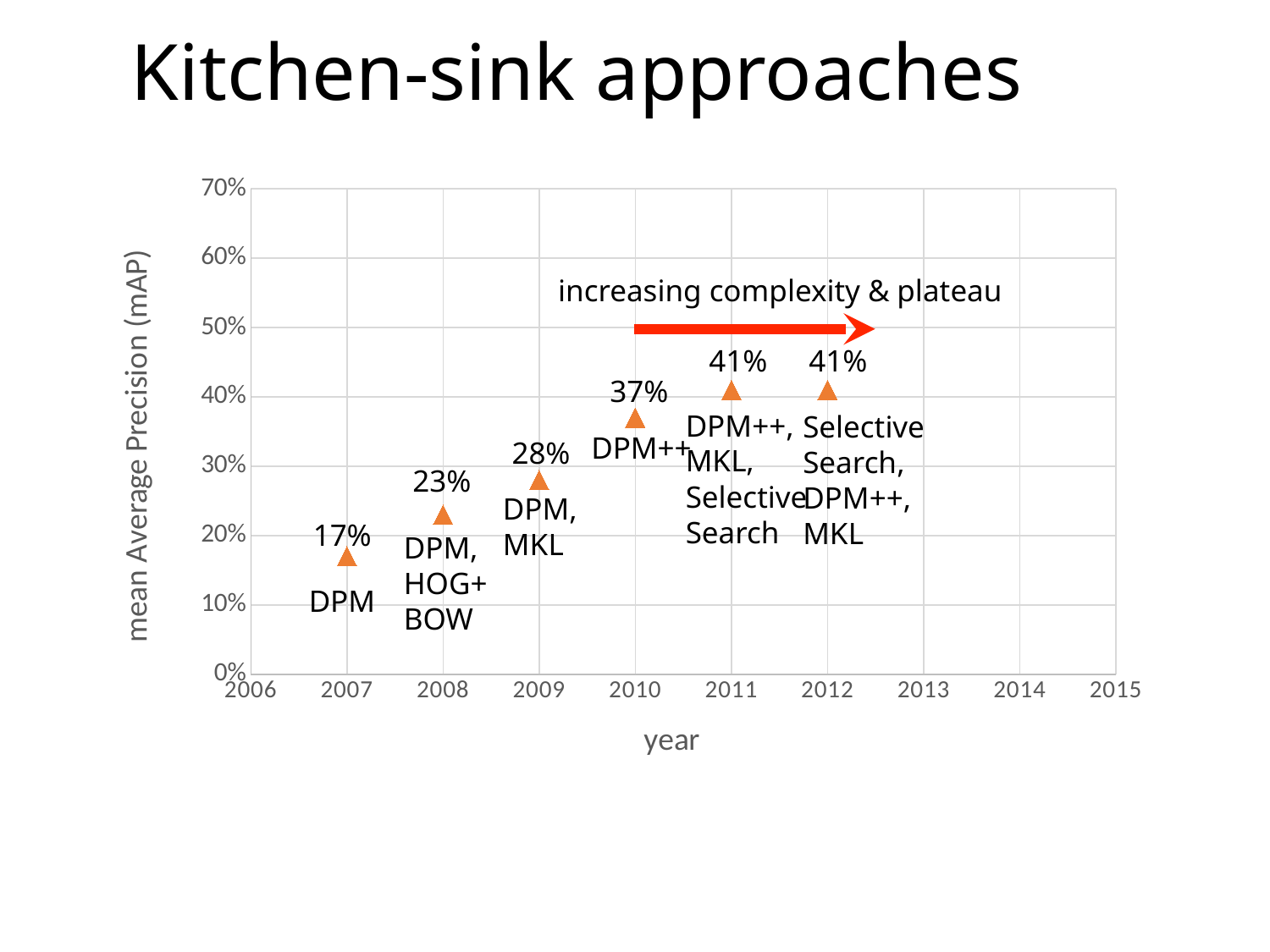
Which year has the lowest plotted mAP value? 2007 What is the label on the y axis of the chart? mean Average Precision (mAP) What is the mAP value plotted for 2010? 37% Which is larger, the mAP value for 2009 or for 2010? 2010 What is the mean Average Precision (mAP) value plotted for 2007? 17% How many data points are plotted on the chart? 6 What kind of chart is shown on the slide? scatter chart What is the mAP value plotted for 2009? 28% What is the difference between the mAP values for 2011 and 2007? 24% What is the difference between the mAP values for 2010 and 2008? 14% Is the mAP value for 2012 greater or less than 50%? less Do the plotted mAP values generally rise or fall from 2007 to 2012? rise